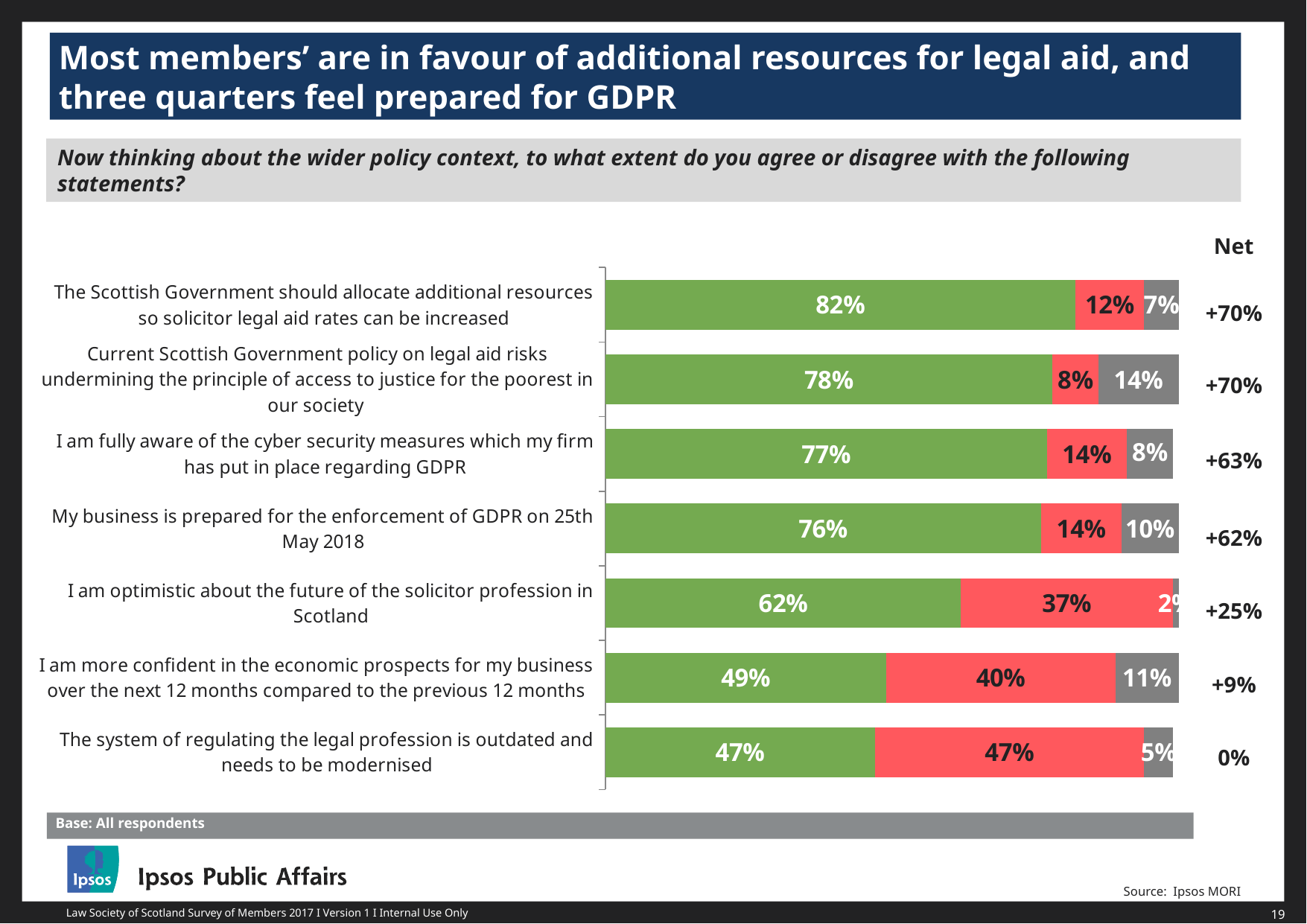
What is the Net value shown for "I am more confident in the economic prospects for my business over the next 12 months compared to the previous 12 months"? +9% Which statement has the largest green segment? The Scottish Government should allocate additional resources so solicitor legal aid rates can be increased What is the red segment value for "I am optimistic about the future of the solicitor profession in Scotland"? 37% Which statement has the smallest green segment? The system of regulating the legal profession is outdated and needs to be modernised Which statement has the largest red segment? The system of regulating the legal profession is outdated and needs to be modernised What is the grey segment value for "I am more confident in the economic prospects for my business over the next 12 months compared to the previous 12 months"? 11% What is the Net value shown for "The system of regulating the legal profession is outdated and needs to be modernised"? 0% Which is larger: the grey segment for "Current Scottish Government policy on legal aid risks undermining the principle of access to justice for the poorest in our society" or the grey segment for "The Scottish Government should allocate additional resources so solicitor legal aid rates can be increased"? Current Scottish Government policy on legal aid risks undermining the principle of access to justice for the poorest in our society What is the green segment value for "My business is prepared for the enforcement of GDPR on 25th May 2018"? 76% What kind of chart is shown on the slide? bar chart What is the difference between the green and red segment values for "The Scottish Government should allocate additional resources so solicitor legal aid rates can be increased"? 70 percentage points How many statements are plotted in the chart? 7